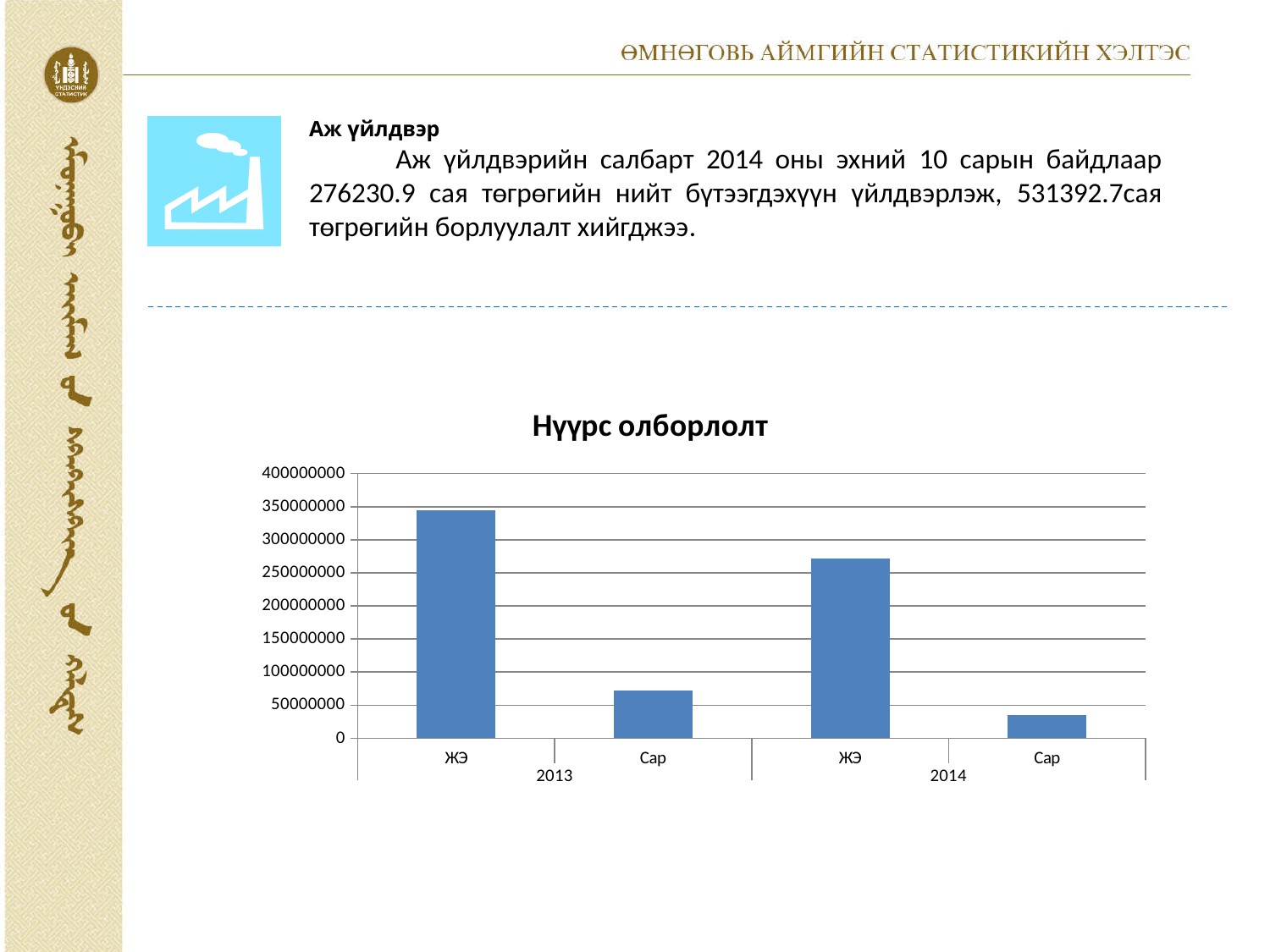
Which is larger, the ЖЭ value for 2013 or the ЖЭ value for 2014? ЖЭ 2013 What kind of chart is shown on the slide? bar chart Is the ЖЭ value for 2014 greater or less than 300000000? less What is the highest value shown on the vertical axis? 400000000 Is the Сар value for 2014 greater or less than 50000000? less Which bar is the highest in the chart? ЖЭ 2013 Is the ЖЭ value for 2013 greater or less than 300000000? greater What is the title of the chart? Нүүрс олборлолт Which bar is the lowest in the chart? Сар 2014 How many bars are plotted in the chart? 4 Which is larger, the Сар value for 2013 or the Сар value for 2014? Сар 2013